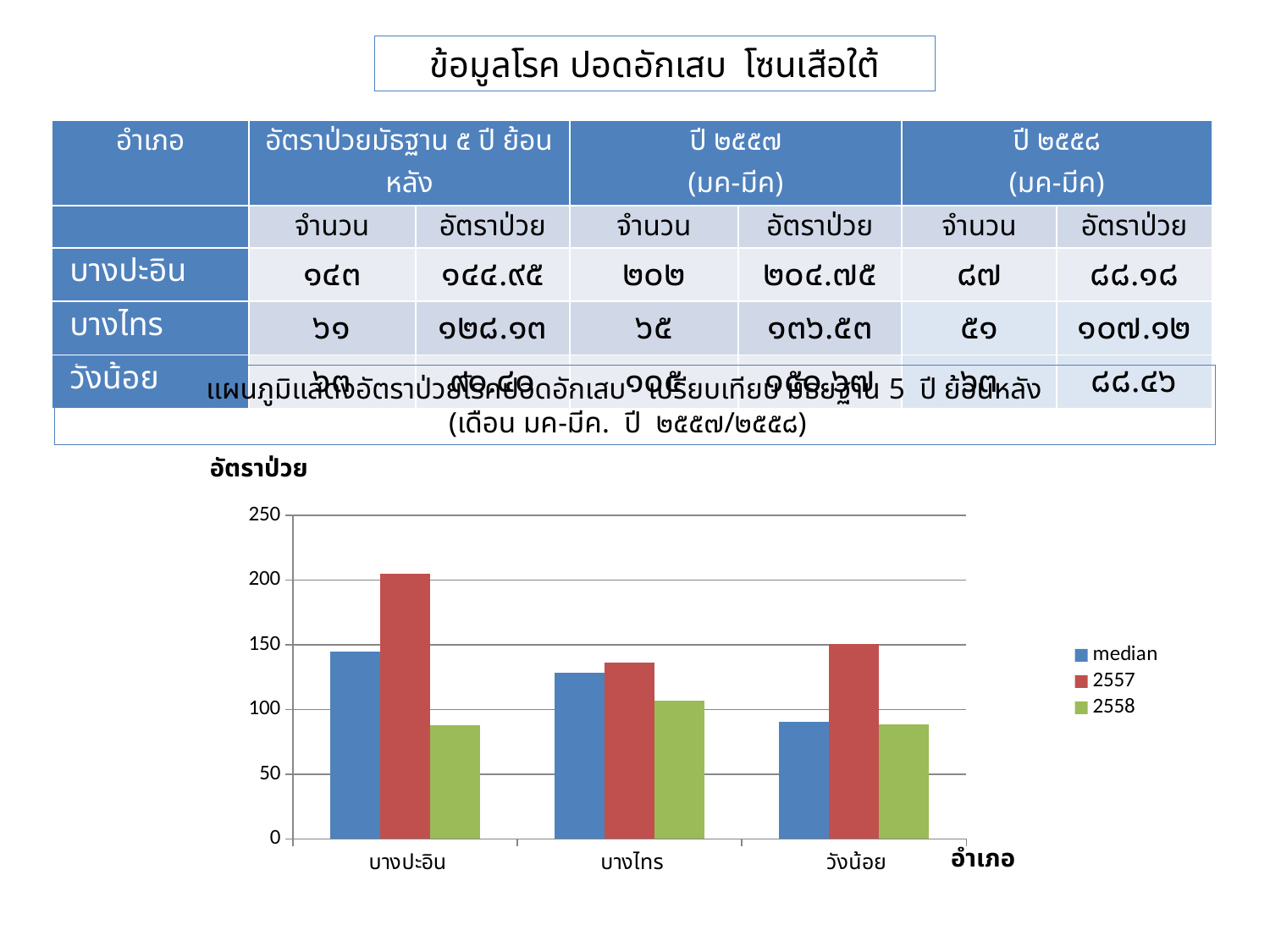
Is the 2558 value for บางปะอิน greater or less than 100? less Which district has the lowest median bar in the chart? วังน้อย How many districts (categories) are shown on the x axis of the chart? 3 How many series does the chart legend list? 3 Is the 2557 value for บางปะอิน greater or less than 150? greater Which district has the highest 2557 bar in the chart? บางปะอิน Which district has the lowest 2557 bar in the chart? บางไทร Is the 2557 value for วังน้อย greater or less than 100? greater Which district has the highest 2558 bar in the chart? บางไทร What kind of chart is shown on the slide? bar chart For วังน้อย, which is larger: the median bar or the 2557 bar? 2557 What label is shown on the vertical axis of the chart? อัตราป่วย